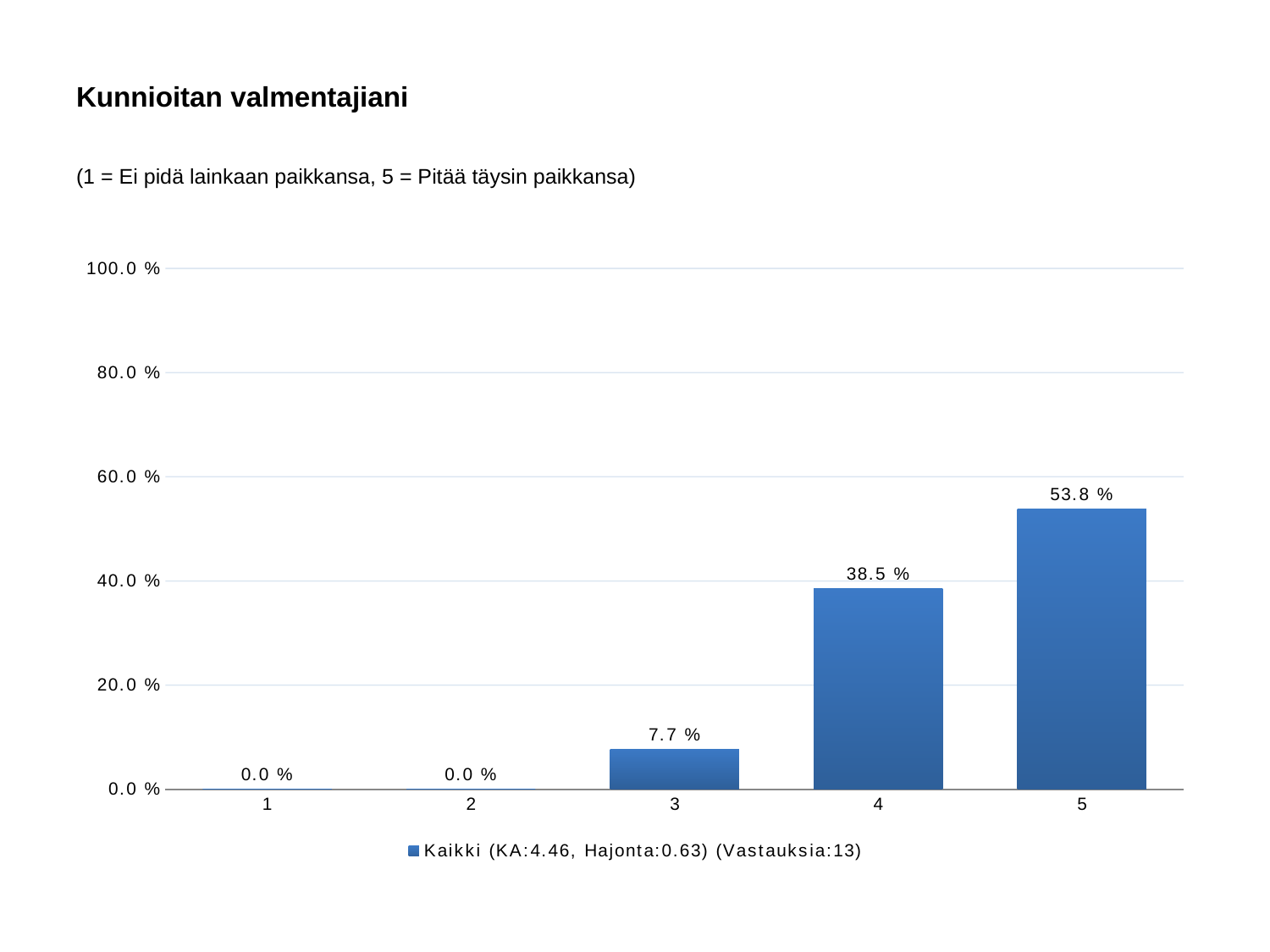
What is the value for category 1? 0.0 % What is the value for category 5? 53.8 % What is the value for category 4? 38.5 % Is the value for category 5 greater or less than 60.0 %? less What is the title of the slide? Kunnioitan valmentajiani How many categories are shown on the x axis? 5 What is the difference between the values for categories 5 and 4? 15.3 % How many series does the legend list? 1 Which is larger, the value for category 3 or the value for category 4? 4 What is the value for category 3? 7.7 % What kind of chart is shown? bar chart Which category has the highest value? 5